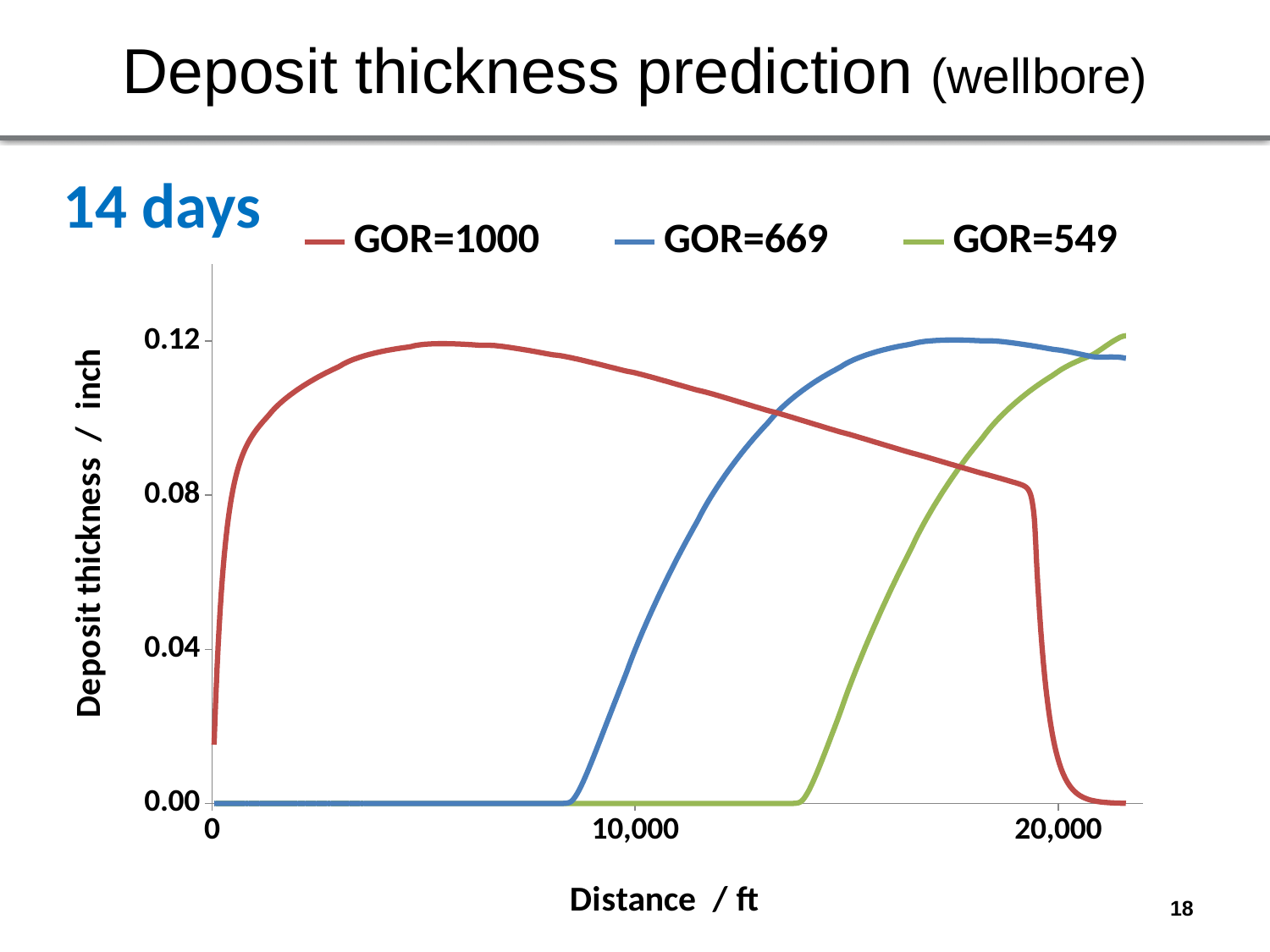
What kind of chart is shown on the slide? line chart At a distance of 10,000 ft, which series has the larger value, GOR=1000 or GOR=669? GOR=1000 Is the value for GOR=1000 at a distance of 20,000 ft greater or less than 0.04? less What is the title of the x axis? Distance / ft Is the value for GOR=669 at a distance of 20,000 ft greater or less than 0.08? greater How many series does the legend list? 3 Does the GOR=1000 series rise or fall between 10,000 ft and 19,000 ft? fall Is the value for GOR=549 at a distance of 10,000 ft greater or less than 0.04? less What is the title of the y axis? Deposit thickness / inch Does the GOR=549 series rise or fall between 15,000 ft and 20,000 ft? rise At a distance of 20,000 ft, which series has the larger value, GOR=669 or GOR=1000? GOR=669